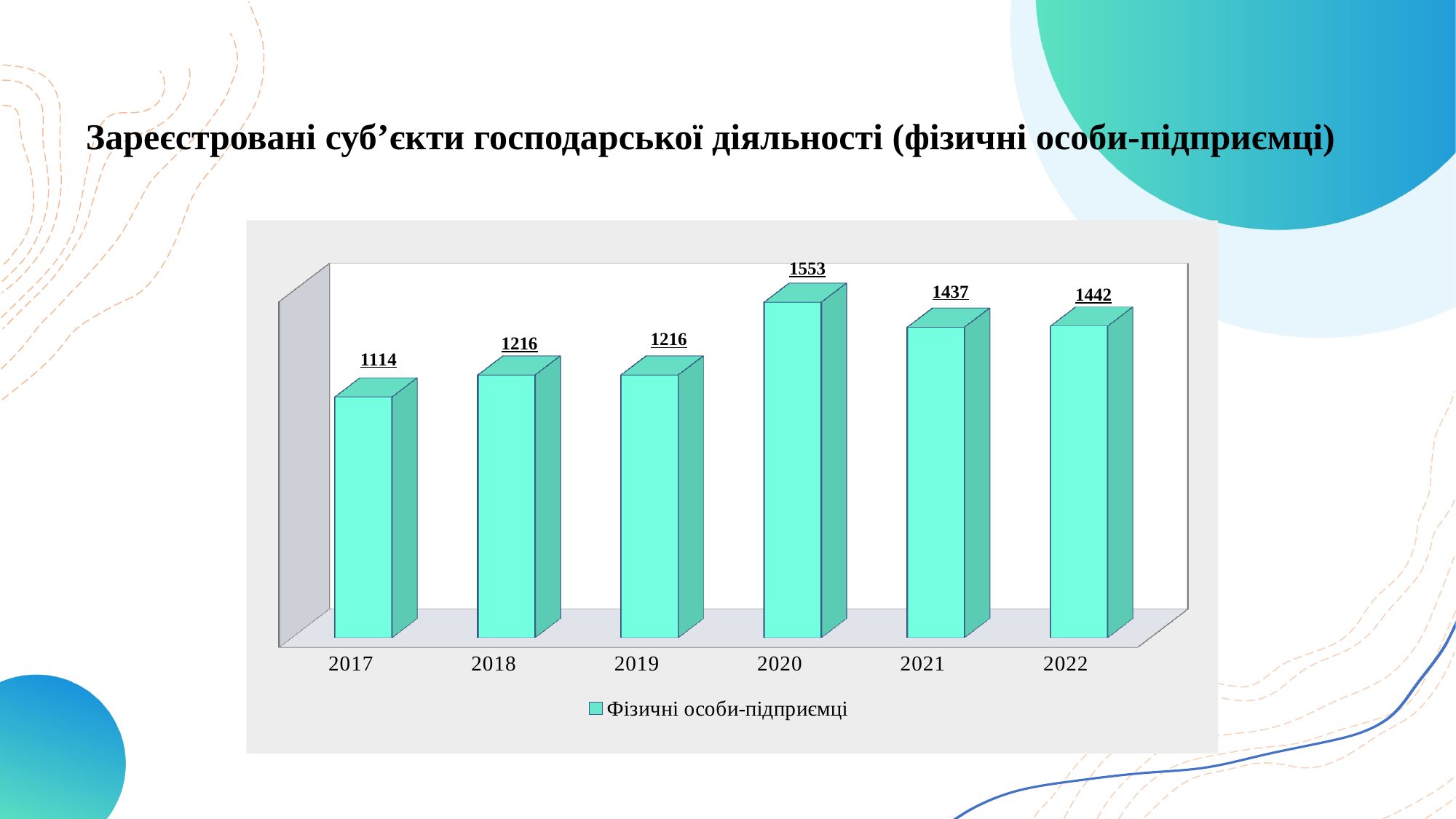
What is the difference between the values for 2018 and 2017? 102 Which year has the highest value? 2020 How many years are shown on the x axis? 6 Which is larger, the value for 2020 or the value for 2022? 2020 Which year has the lowest value? 2017 What is the difference between the values for 2020 and 2021? 116 What kind of chart is shown? bar chart How many series does the legend list? 1 What is the value for 2020? 1553 What is the value for 2022? 1442 What is the value for 2017? 1114 What is the legend entry for the series? Фізичні особи-підприємці